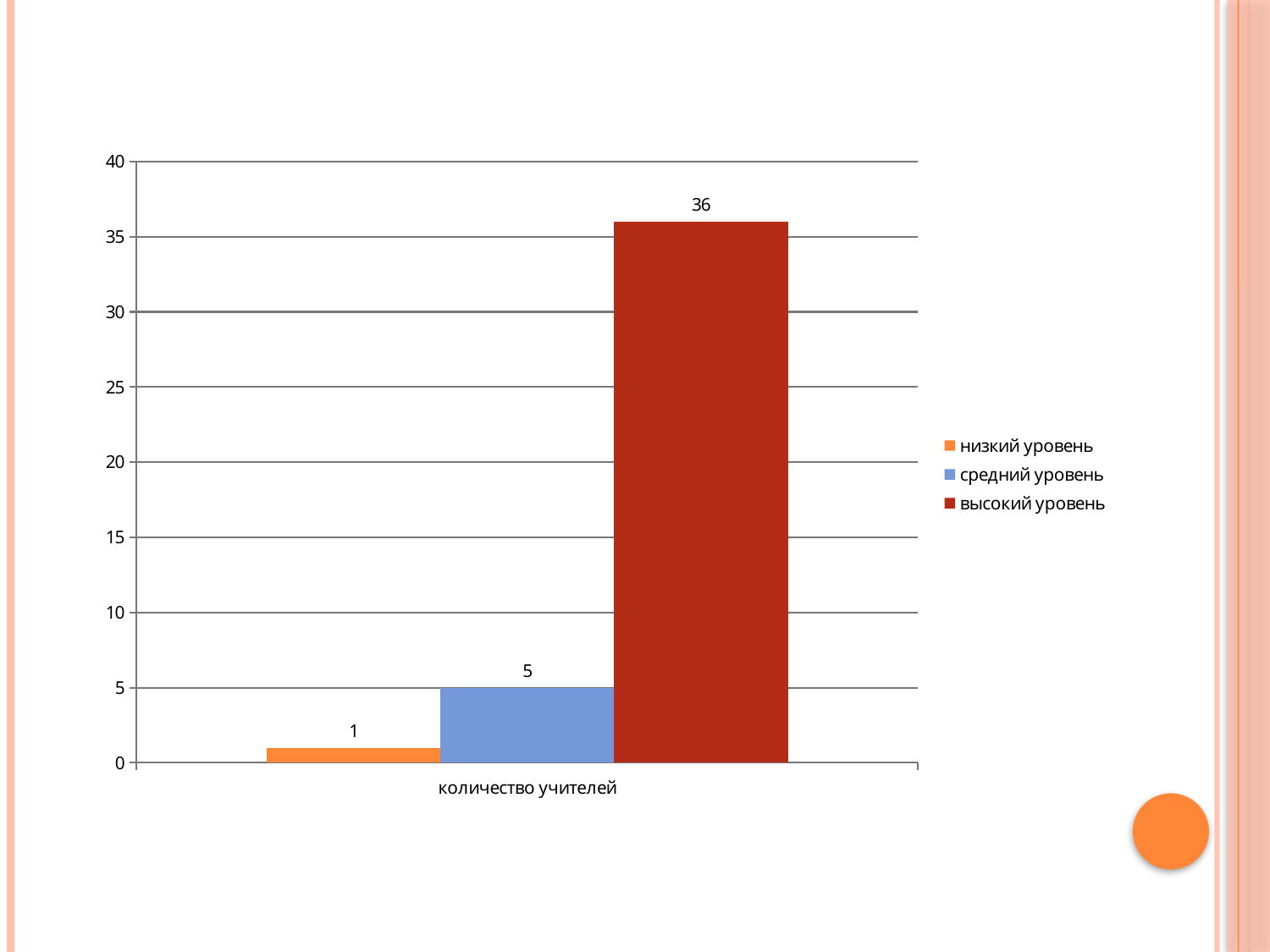
How many series does the legend list? 3 What is the label on the x axis category? количество учителей What is the value for высокий уровень? 36 What is the value for средний уровень? 5 What is the difference between the values for средний уровень and низкий уровень? 4 What is the difference between the values for высокий уровень and средний уровень? 31 What is the value for низкий уровень? 1 Which series has the lowest value? низкий уровень What kind of chart is shown on the slide? bar chart Which series has the highest value? высокий уровень Which is larger, the value for средний уровень or the value for низкий уровень? средний уровень Is the value for высокий уровень greater or less than 30? greater